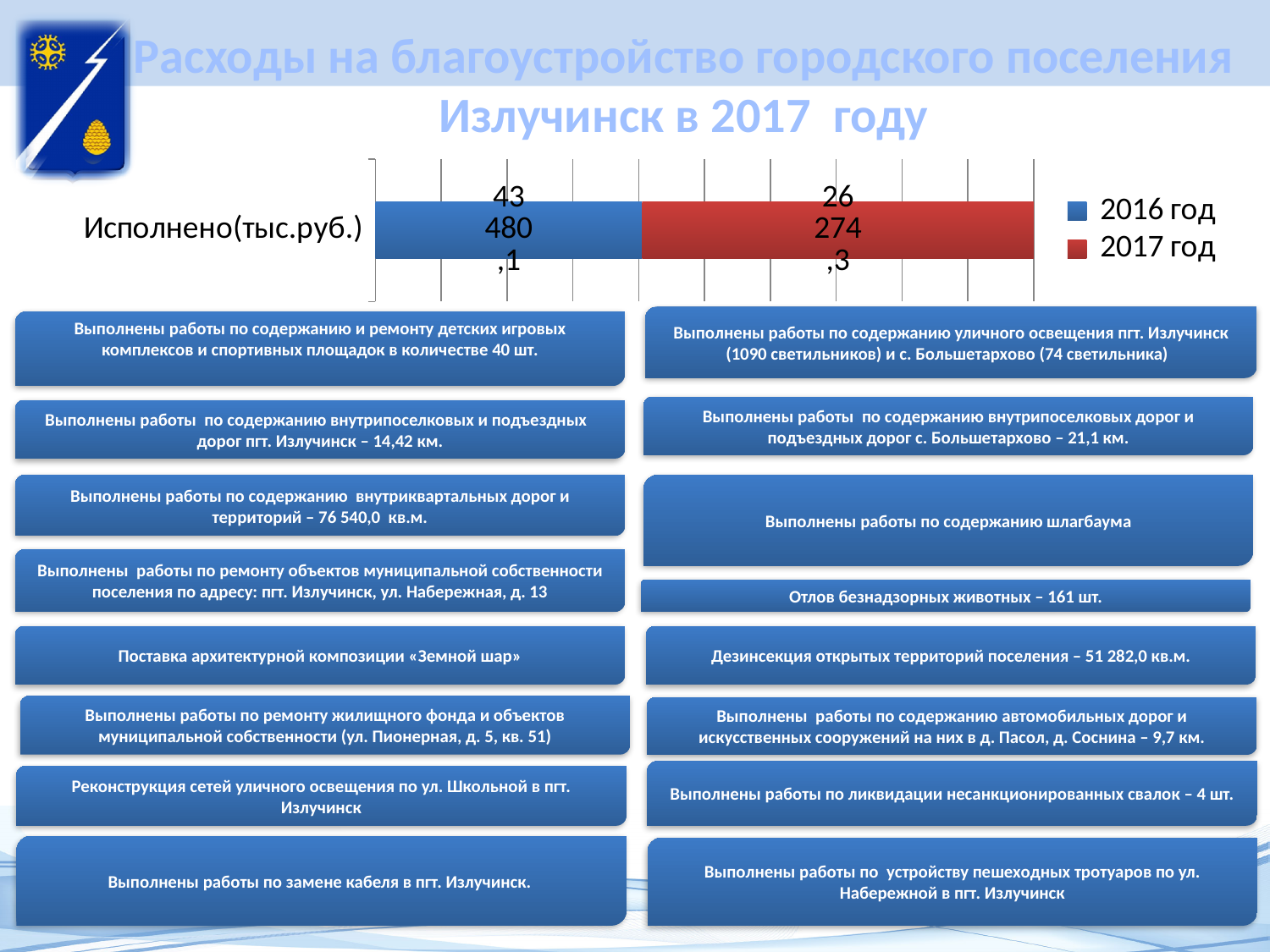
How many series does the legend list? 2 What is the value for 2016 год in the chart? 43 480,1 What kind of chart is shown on the slide? Bar chart What is the total of the stacked bar for Исполнено(тыс.руб.)? 69 754,4 How many categories are shown on the chart's axis? 1 What is the category label shown on the chart's axis? Исполнено(тыс.руб.) What is the value for 2017 год in the chart? 26 274,3 What is the difference between the 2016 год and 2017 год values? 17 205,8 What colour represents 2017 год in the chart? Red